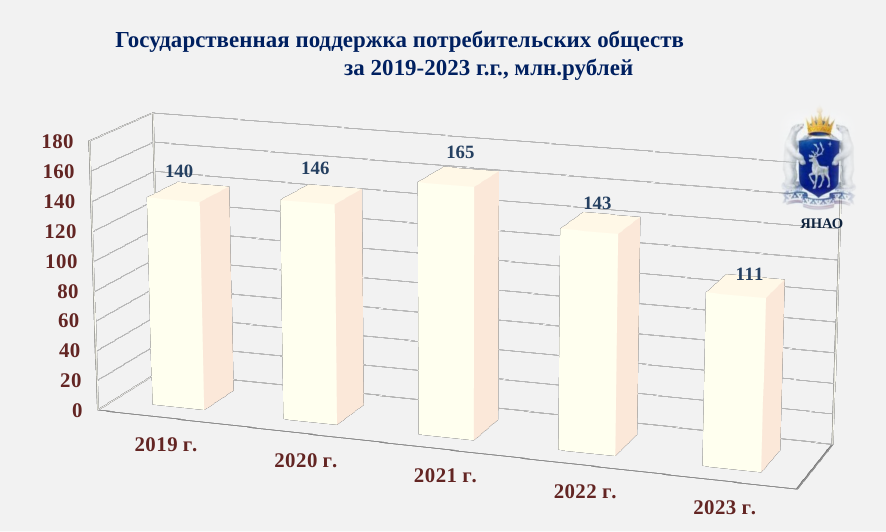
What is the value for 2019 г.? 140 Which is larger, the value for 2020 г. or the value for 2022 г.? 2020 г. What is the value for 2021 г.? 165 Which year has the lowest value? 2023 г. What unit is stated in the chart title? млн.рублей What kind of chart is shown on the slide? bar chart What is the difference between the values for 2021 г. and 2023 г.? 54 Which year has the highest value? 2021 г. What is the value for 2023 г.? 111 Do the values rise or fall from 2021 г. to 2023 г.? fall What is the difference between the values for 2020 г. and 2019 г.? 6 How many years are shown on the chart? 5